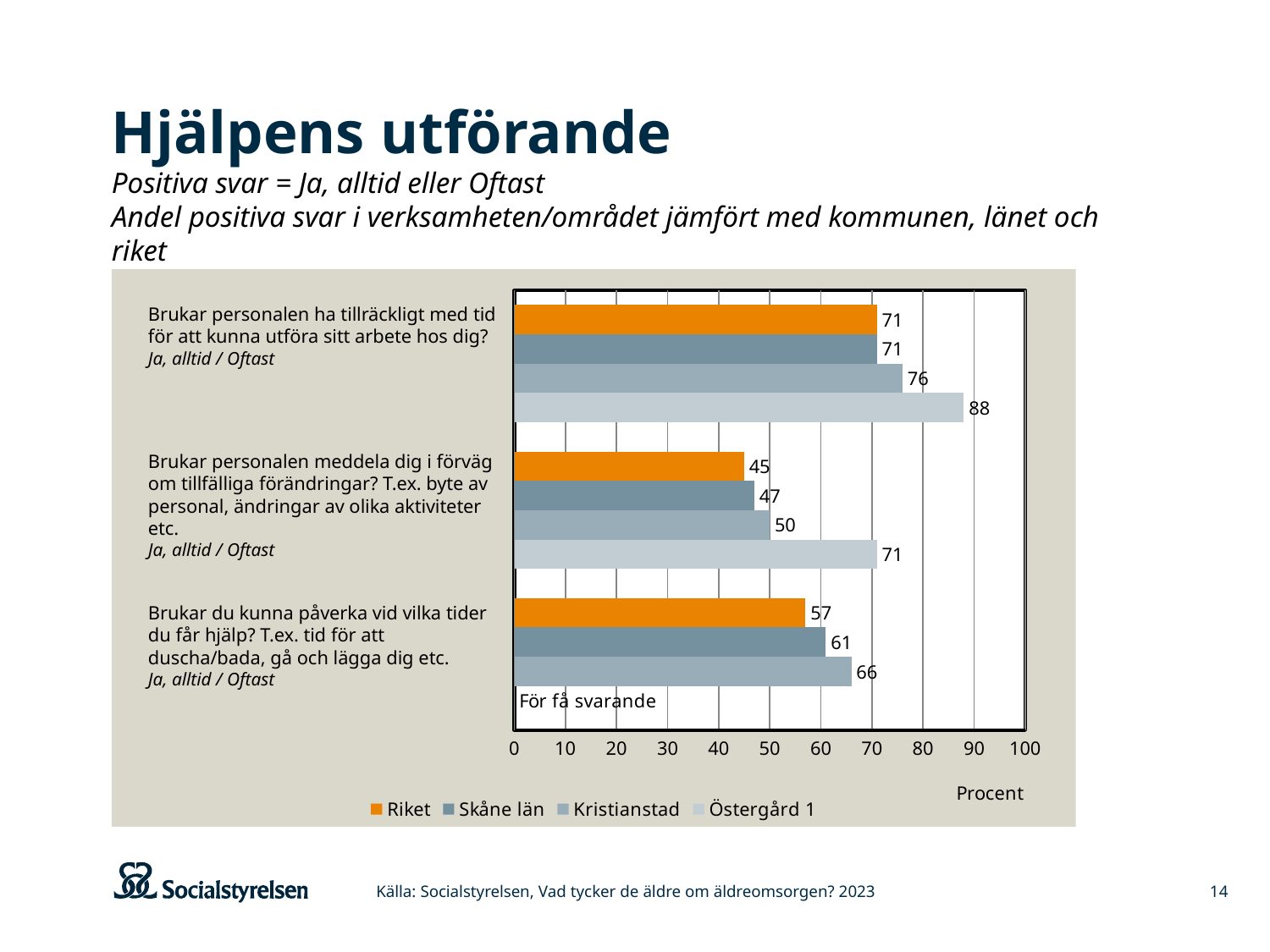
Which is larger on the question "Brukar du kunna påverka vid vilka tider du får hjälp?": Skåne län or Kristianstad? Kristianstad What unit is shown on the x axis of the chart? Procent What is the value for Riket on the question "Brukar personalen meddela dig i förväg om tillfälliga förändringar?"? 45 What is the value for Kristianstad on the question "Brukar du kunna påverka vid vilka tider du får hjälp?"? 66 Which series has the highest value on the question "Brukar personalen meddela dig i förväg om tillfälliga förändringar?"? Östergård 1 What is shown instead of a bar for Östergård 1 on the question "Brukar du kunna påverka vid vilka tider du får hjälp?"? För få svarande Which series has the lowest value on the question "Brukar du kunna påverka vid vilka tider du får hjälp?"? Riket What is the value for Östergård 1 on the question "Brukar personalen ha tillräckligt med tid för att kunna utföra sitt arbete hos dig?"? 88 How many questions (categories) are shown on the chart? 3 What kind of chart is shown on the slide? Bar chart How many series does the legend list? 4 What is the difference between Östergård 1 and Riket on the question "Brukar personalen ha tillräckligt med tid för att kunna utföra sitt arbete hos dig?"? 17